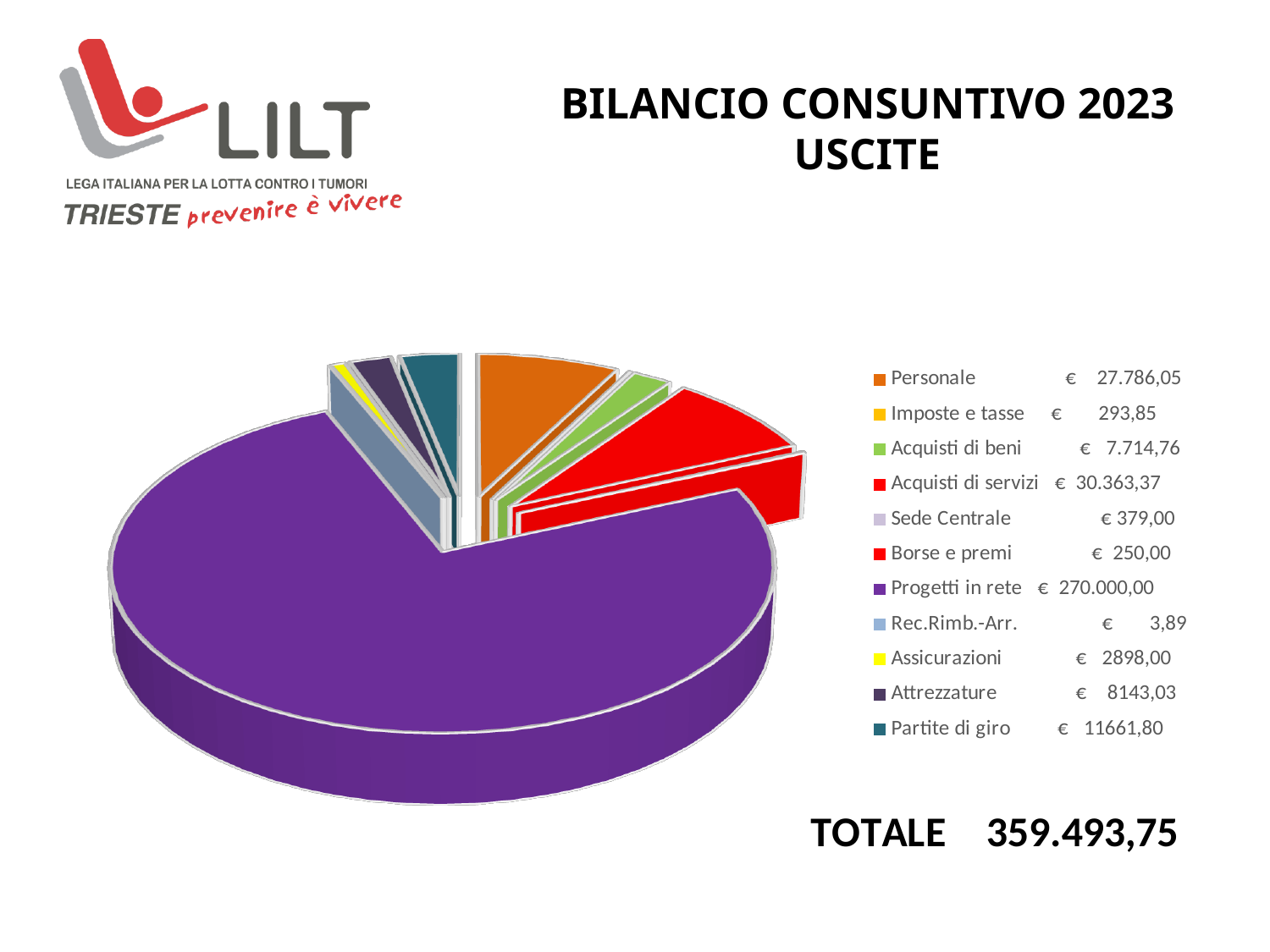
What is the difference between Acquisti di servizi and Personale? € 2.577,32 What is the value for Partite di giro? € 11661,80 Which is larger, Attrezzature or Acquisti di beni? Attrezzature What is the title of the slide containing the pie chart? BILANCIO CONSUNTIVO 2023 USCITE What is the value for Sede Centrale? € 379,00 Which category has the smallest value? Rec.Rimb.-Arr. Which category has the largest value? Progetti in rete What is the value for Progetti in rete? € 270.000,00 What is the value for Personale? € 27.786,05 What is the total shown for all the expenses (TOTALE)? 359.493,75 What kind of chart is shown on the slide? Pie chart How many categories does the pie chart's legend list? 11